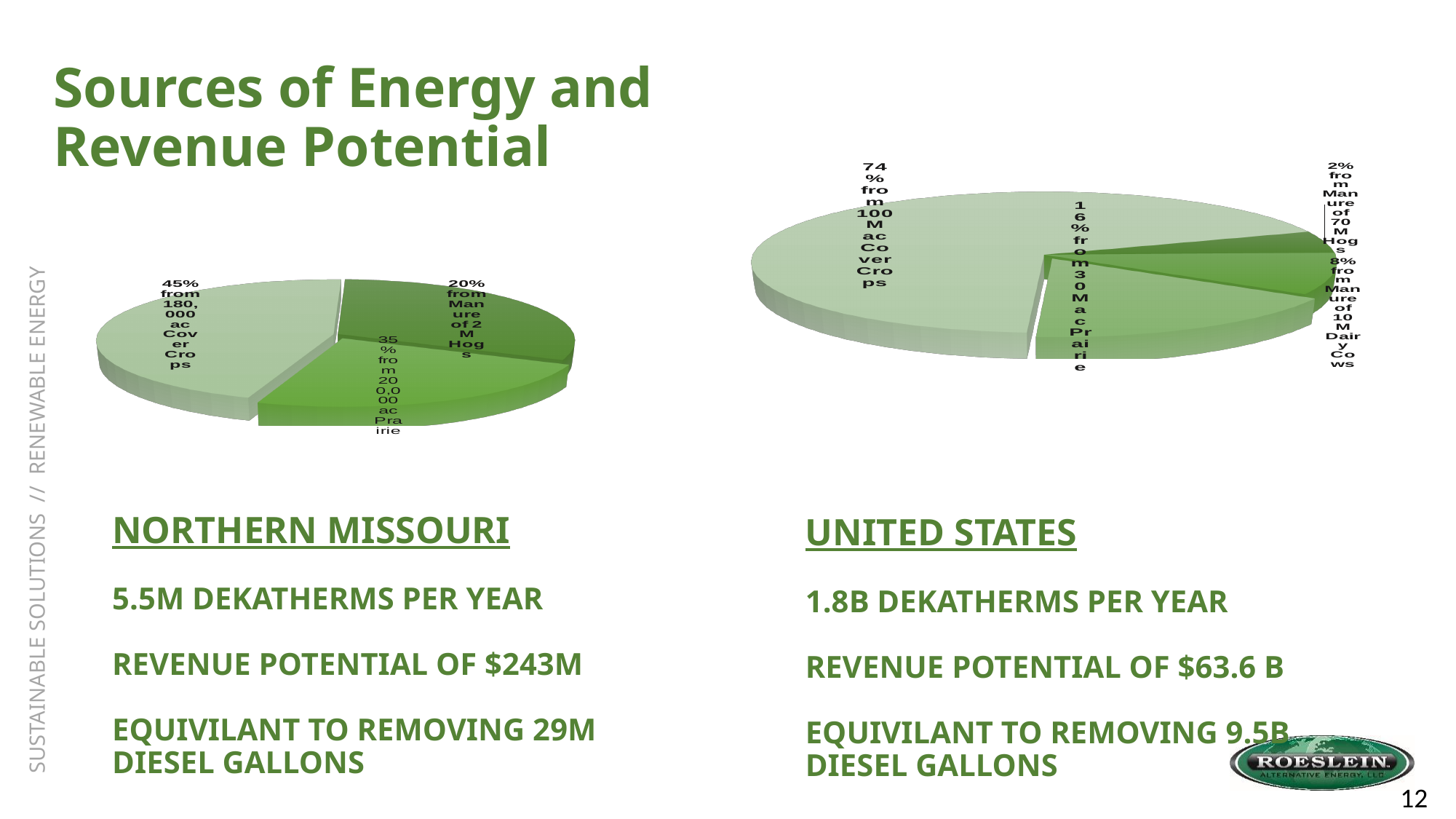
In the left pie chart (Northern Missouri), how many slices are there? 3 In the right pie chart (United States), which source has the smallest share? Manure of 70M Hogs In the right pie chart (United States), how many slices are there? 4 In the left pie chart (Northern Missouri), what share comes from 180,000 ac Cover Crops? 45% What kind of chart is shown on the left side of the slide? pie chart In the left pie chart (Northern Missouri), which is larger: the share from 200,000 ac Prairie or the share from Manure of 2M Hogs? 200,000 ac Prairie In the left pie chart (Northern Missouri), what share comes from 200,000 ac Prairie? 35% In the left pie chart (Northern Missouri), which source has the largest share? 180,000 ac Cover Crops In the right pie chart (United States), what share comes from Manure of 10M Dairy Cows? 8% In the right pie chart (United States), what is the difference between the share from 30M ac Prairie and the share from Manure of 10M Dairy Cows? 8%